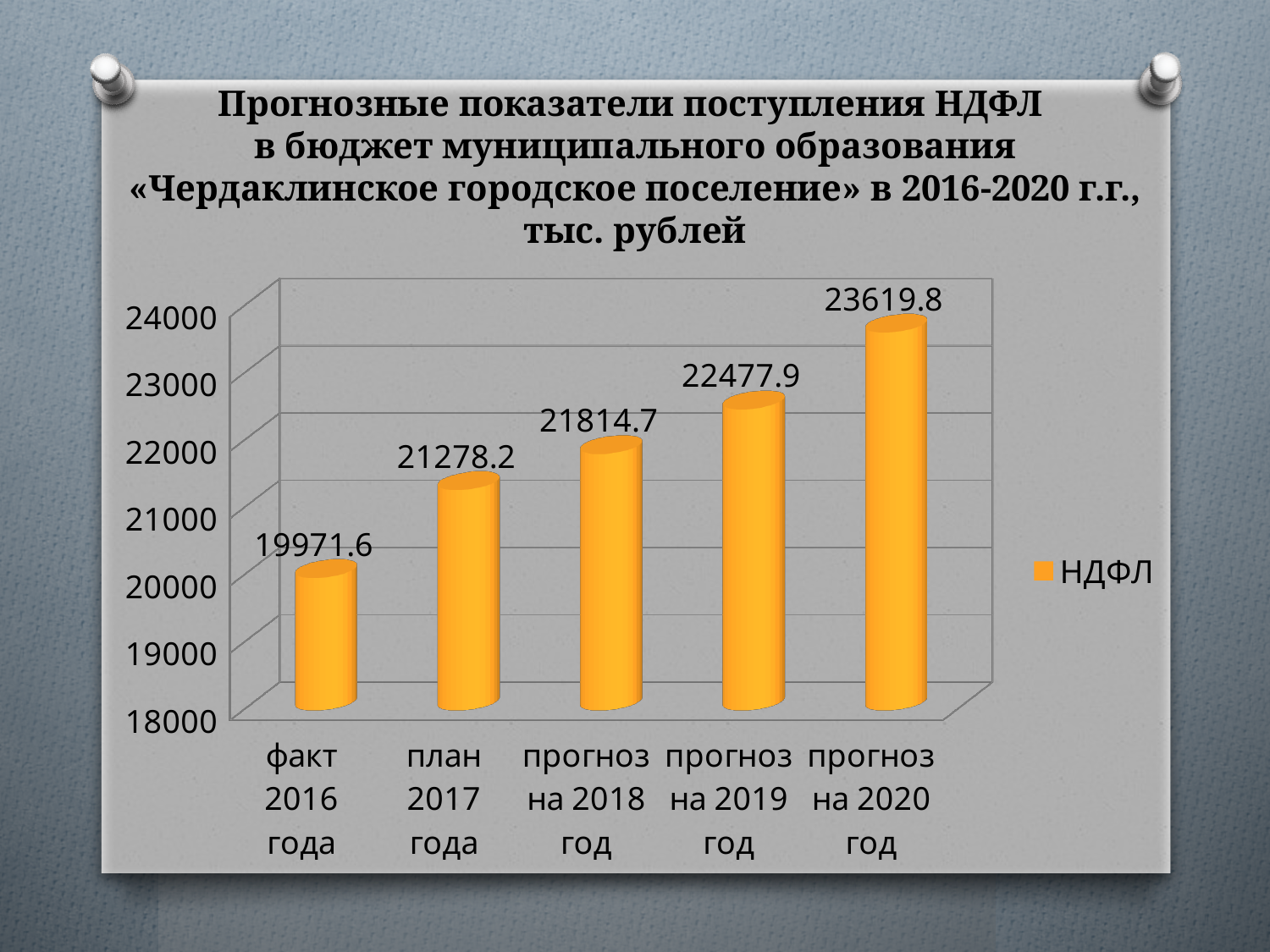
Which category has the lowest value? факт 2016 года How many categories are shown on the x axis? 5 What is the value for прогноз на 2020 год? 23619.8 Which category has the highest value? прогноз на 2020 год What kind of chart is shown on the slide? bar chart What is the value for прогноз на 2018 год? 21814.7 What is the difference between the values for прогноз на 2020 год and факт 2016 года? 3648.2 Do the values rise or fall from left to right along the x axis? rise What is the value for факт 2016 года? 19971.6 What is the difference between the values for прогноз на 2019 год and прогноз на 2018 год? 663.2 What is the value for план 2017 года? 21278.2 Which is larger, the value for план 2017 года or the value for прогноз на 2019 год? прогноз на 2019 год